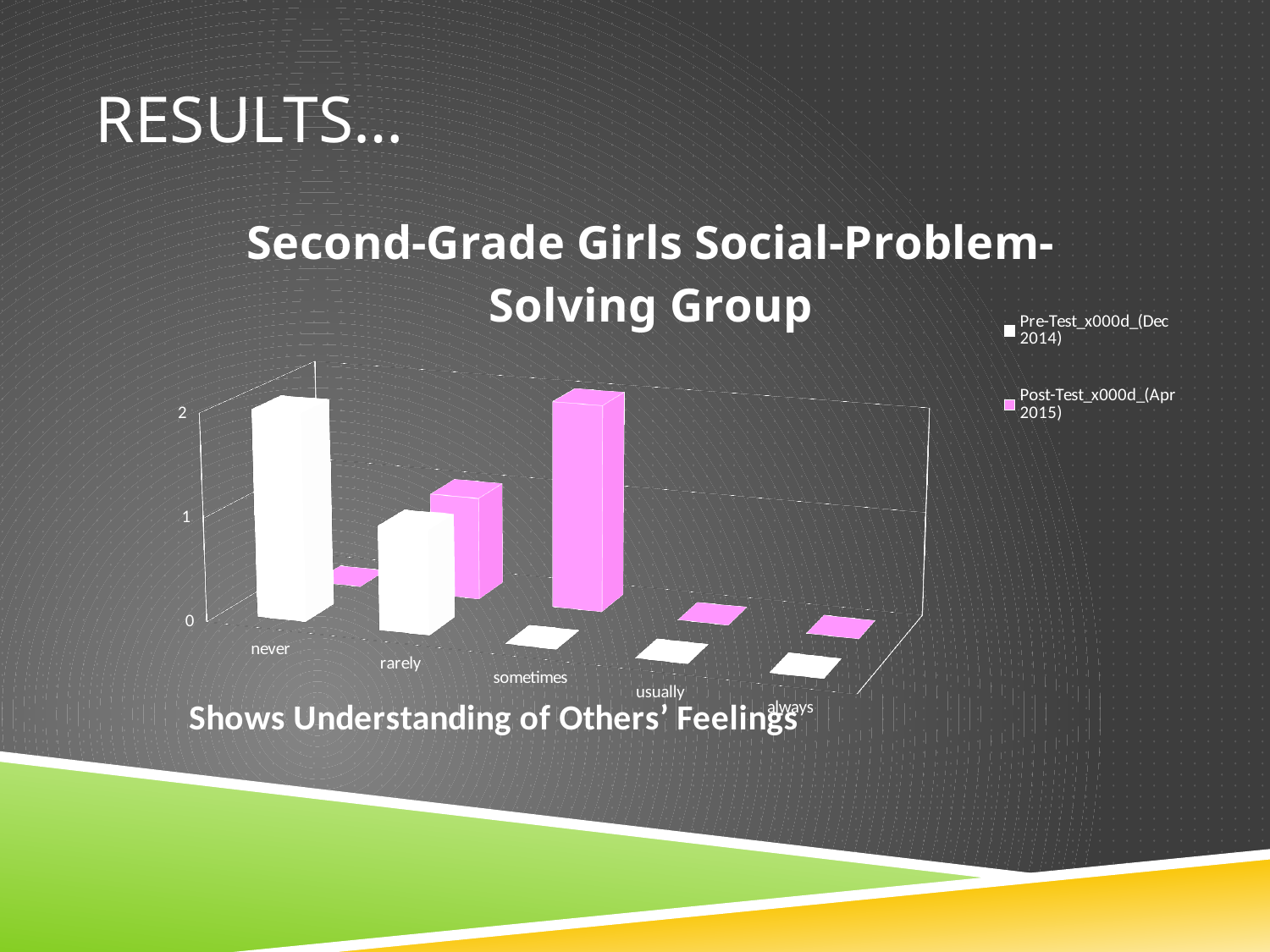
For the 'never' category, which series has the larger value, Pre-Test (Dec 2014) or Post-Test (Apr 2015)? Pre-Test (Dec 2014) For the Pre-Test (Dec 2014) series, which category has the highest value? never Which colour represents the Post-Test (Apr 2015) series in the chart? pink Is the Post-Test (Apr 2015) value for 'sometimes' greater or less than 1? greater For the Post-Test (Apr 2015) series, which category has the highest value? sometimes What kind of chart is shown on the slide? bar chart How many series does the chart's legend list? 2 Is the Pre-Test (Dec 2014) value for 'rarely' greater or less than 2? less How many categories are shown on the x axis of the chart? 5 What is the title of the chart? Second-Grade Girls Social-Problem-Solving Group For the 'sometimes' category, which series has the larger value, Pre-Test (Dec 2014) or Post-Test (Apr 2015)? Post-Test (Apr 2015) Is the Pre-Test (Dec 2014) value for 'never' greater or less than 1? greater